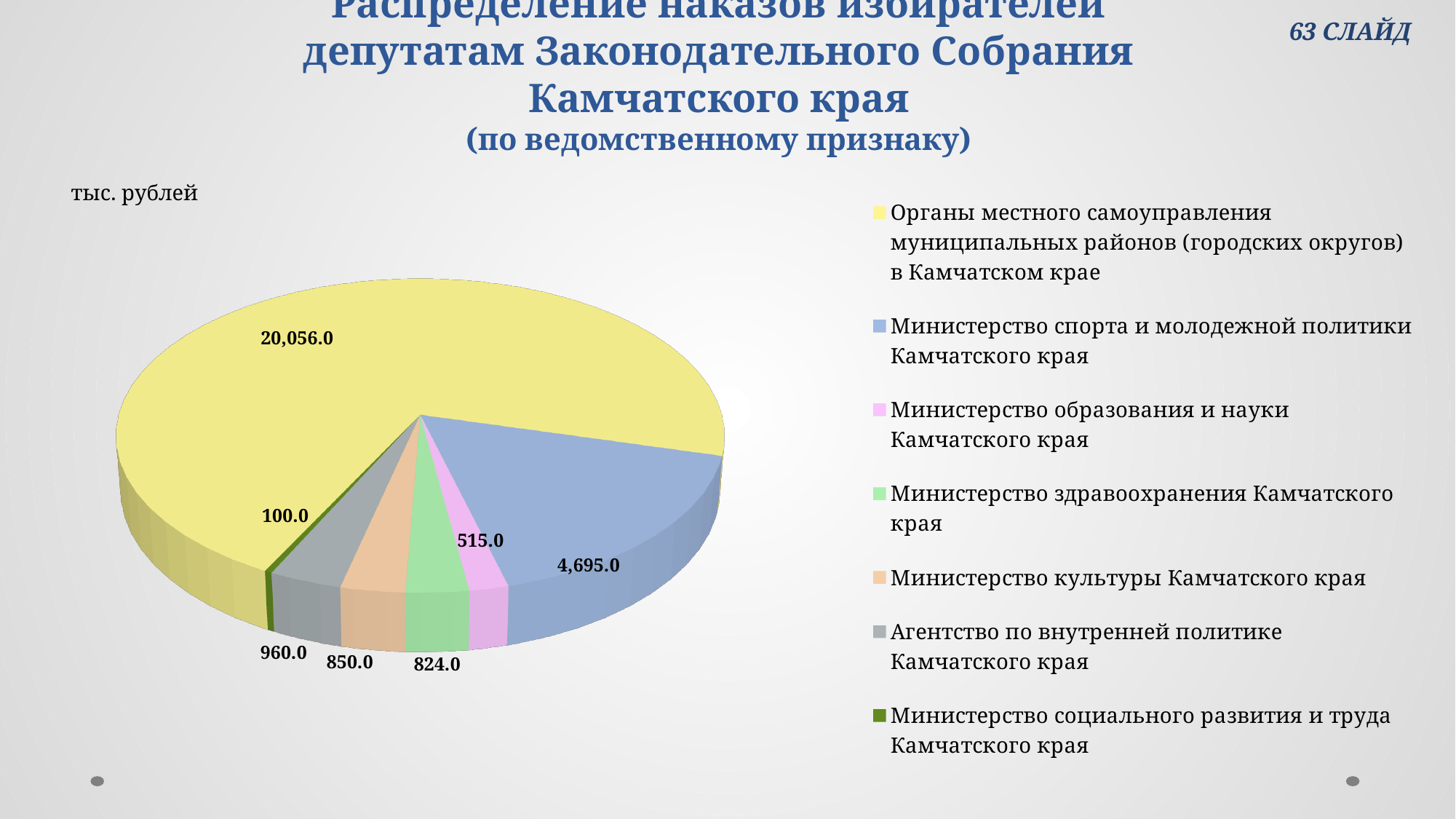
What is the value for Органы местного самоуправления муниципальных районов (городских округов) в Камчатском крае? 20,056.0 Which is larger: the value for Агентство по внутренней политике Камчатского края or the value for Министерство культуры Камчатского края? Агентство по внутренней политике Камчатского края What unit is stated for the values in the chart? тыс. рублей Which category has the largest slice of the pie? Органы местного самоуправления муниципальных районов (городских округов) в Камчатском крае Which category has the smallest slice of the pie? Министерство социального развития и труда Камчатского края What type of chart is shown on the slide? Pie chart How many slices does the pie chart have? 7 What is the difference between the values for Министерство культуры Камчатского края and Министерство здравоохранения Камчатского края? 26.0 What is the value for Министерство спорта и молодежной политики Камчатского края? 4,695.0 What is the value for Министерство образования и науки Камчатского края? 515.0 What is the total of all slices in the pie chart? 28,000.0 What is the value for Агентство по внутренней политике Камчатского края? 960.0